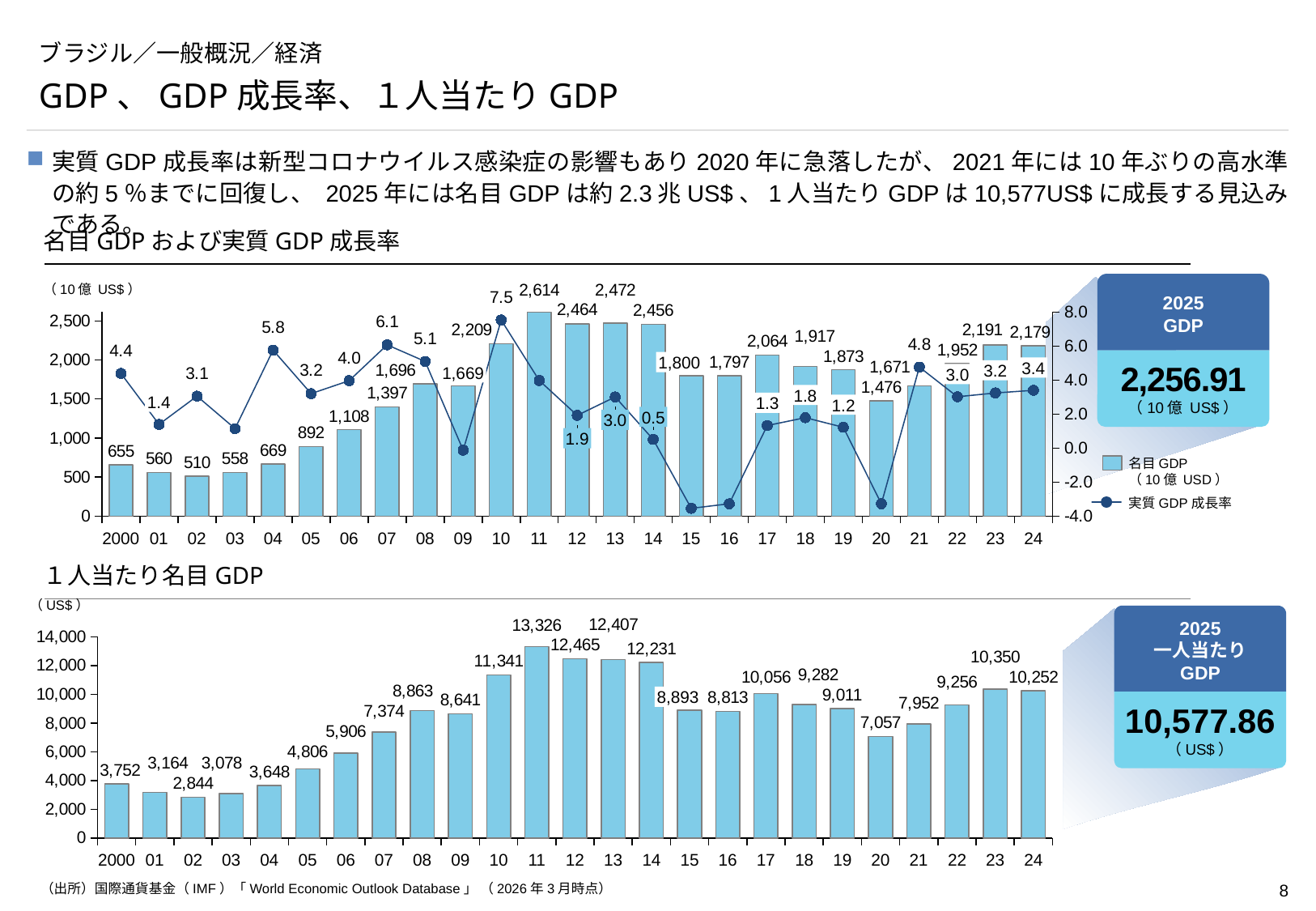
In the top chart (名目GDPおよび実質GDP成長率), which year has the lowest nominal GDP bar? 02 In the bottom chart (1人当たり名目GDP), which is larger, the value for 2017 or the value for 2018? 2017 In the top chart (名目GDPおよび実質GDP成長率), what is the nominal GDP value for 2011? 2,614 In the bottom chart (1人当たり名目GDP), what is the value for 2020? 7,057 In the top chart (名目GDPおよび実質GDP成長率), is the real GDP growth rate for 2015 greater or less than -2.0? less In the top chart (名目GDPおよび実質GDP成長率), what is the difference between the nominal GDP of 2023 and 2024? 12 In the bottom chart (1人当たり名目GDP), how many years are plotted on the x axis? 25 What type of chart is the bottom chart (1人当たり名目GDP)? Bar chart In the top chart (名目GDPおよび実質GDP成長率), what is the real GDP growth rate shown for 2010? 7.5 In the bottom chart (1人当たり名目GDP), what is the difference between the values for 2023 and 2024? 98 In the bottom chart (1人当たり名目GDP), which year has the highest value? 11 In the top chart (名目GDPおよび実質GDP成長率), how many series does the legend list? 2